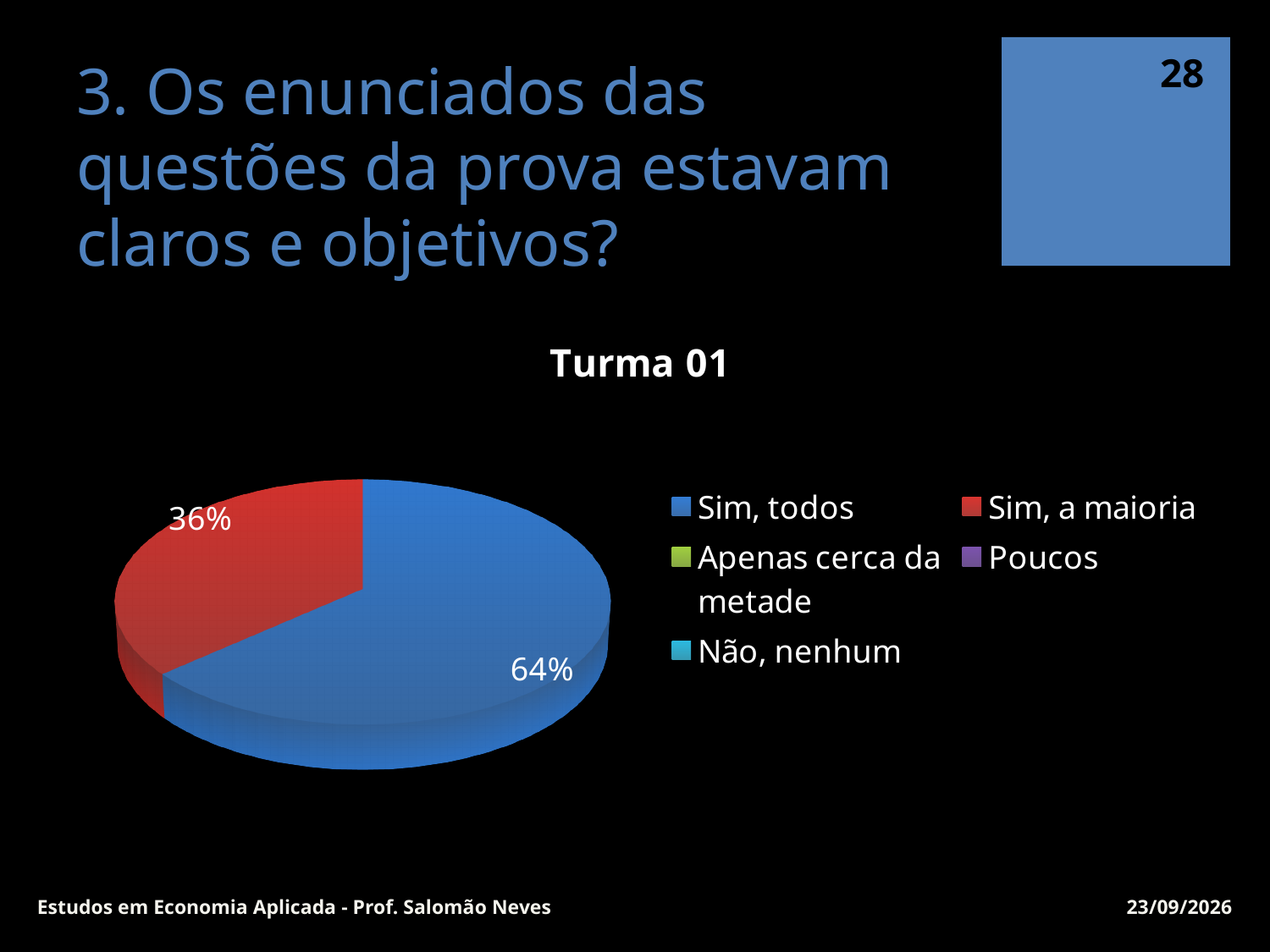
Which category has the largest slice of the pie? Sim, todos What is the title of the chart? Turma 01 How many slices are visible in the pie? 2 What share of the pie does "Sim, todos" represent? 64% Which is larger, the slice for "Sim, todos" or the slice for "Sim, a maioria"? Sim, todos What kind of chart is shown on the slide? Pie chart Which of the slices shown in the pie is the smallest? Sim, a maioria What colour is the slice for "Sim, a maioria"? Red What is the difference in percentage points between "Sim, todos" and "Sim, a maioria"? 28 Is the share for "Sim, todos" greater or less than 50%? greater What share of the pie does "Sim, a maioria" represent? 36% How many entries does the legend list? 5